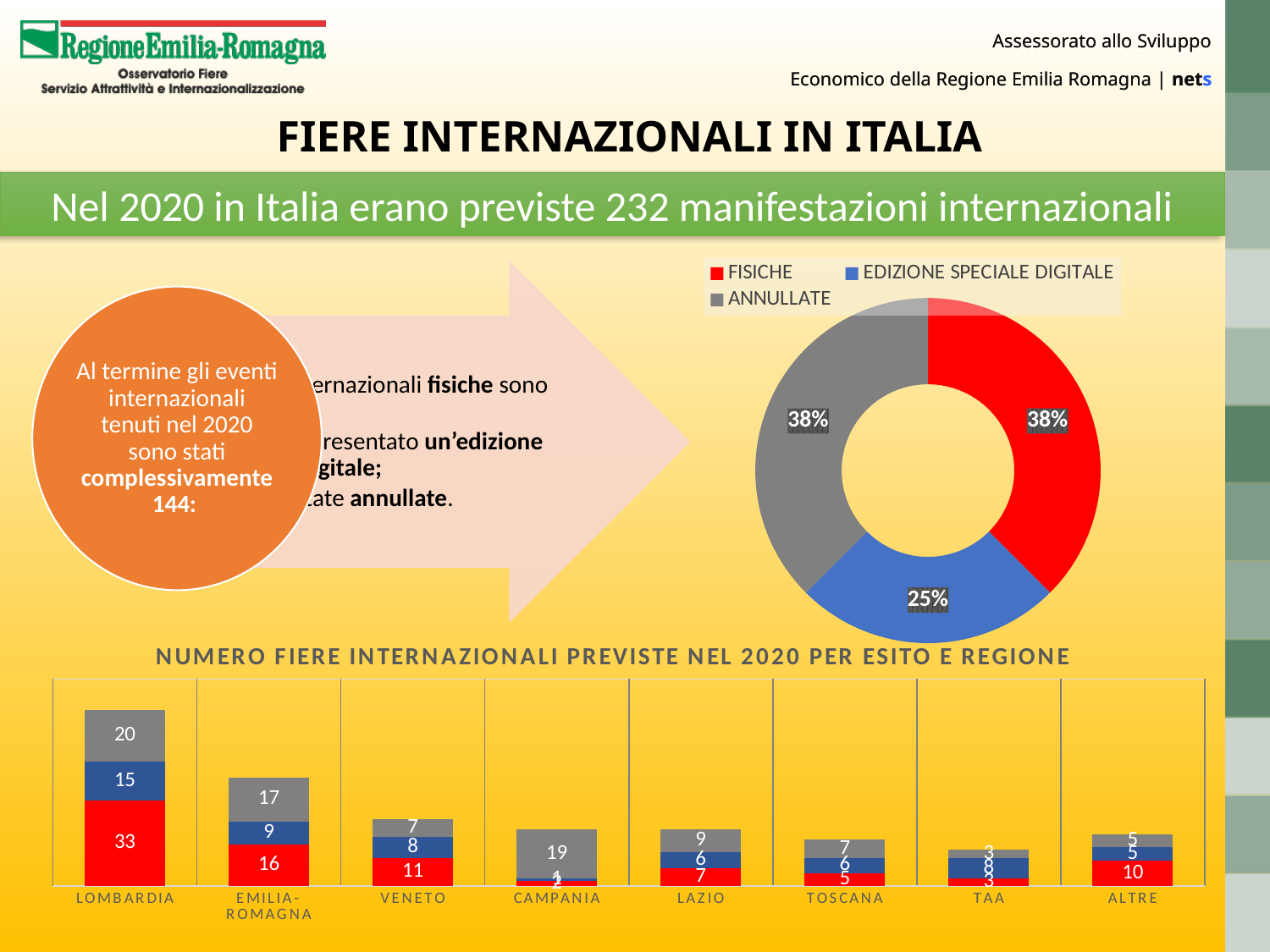
In the donut chart at the top right, which category has the smallest share? EDIZIONE SPECIALE DIGITALE In the donut chart at the top right, what share is shown for FISICHE? 38% In the chart 'NUMERO FIERE INTERNAZIONALI PREVISTE NEL 2020 PER ESITO E REGIONE', what is the difference between the red (FISICHE) values for LOMBARDIA and EMILIA-ROMAGNA? 17 What kind of chart is the chart at the top right of the slide with the FISICHE, EDIZIONE SPECIALE DIGITALE and ANNULLATE legend? Donut (pie) chart How many series does the legend of the donut chart at the top right list? 3 In the chart 'NUMERO FIERE INTERNAZIONALI PREVISTE NEL 2020 PER ESITO E REGIONE', how many regions are shown on the x axis? 8 In the chart 'NUMERO FIERE INTERNAZIONALI PREVISTE NEL 2020 PER ESITO E REGIONE', what is the total of the stacked bar for LOMBARDIA? 68 In the chart 'NUMERO FIERE INTERNAZIONALI PREVISTE NEL 2020 PER ESITO E REGIONE', what is the value of the grey (ANNULLATE) segment for EMILIA-ROMAGNA? 17 What kind of chart is 'NUMERO FIERE INTERNAZIONALI PREVISTE NEL 2020 PER ESITO E REGIONE'? Stacked bar chart In the chart 'NUMERO FIERE INTERNAZIONALI PREVISTE NEL 2020 PER ESITO E REGIONE', what is the value of the red (FISICHE) segment for LOMBARDIA? 33 In the chart 'NUMERO FIERE INTERNAZIONALI PREVISTE NEL 2020 PER ESITO E REGIONE', which region has the tallest stacked bar? LOMBARDIA In the donut chart at the top right, what share is shown for EDIZIONE SPECIALE DIGITALE? 25%